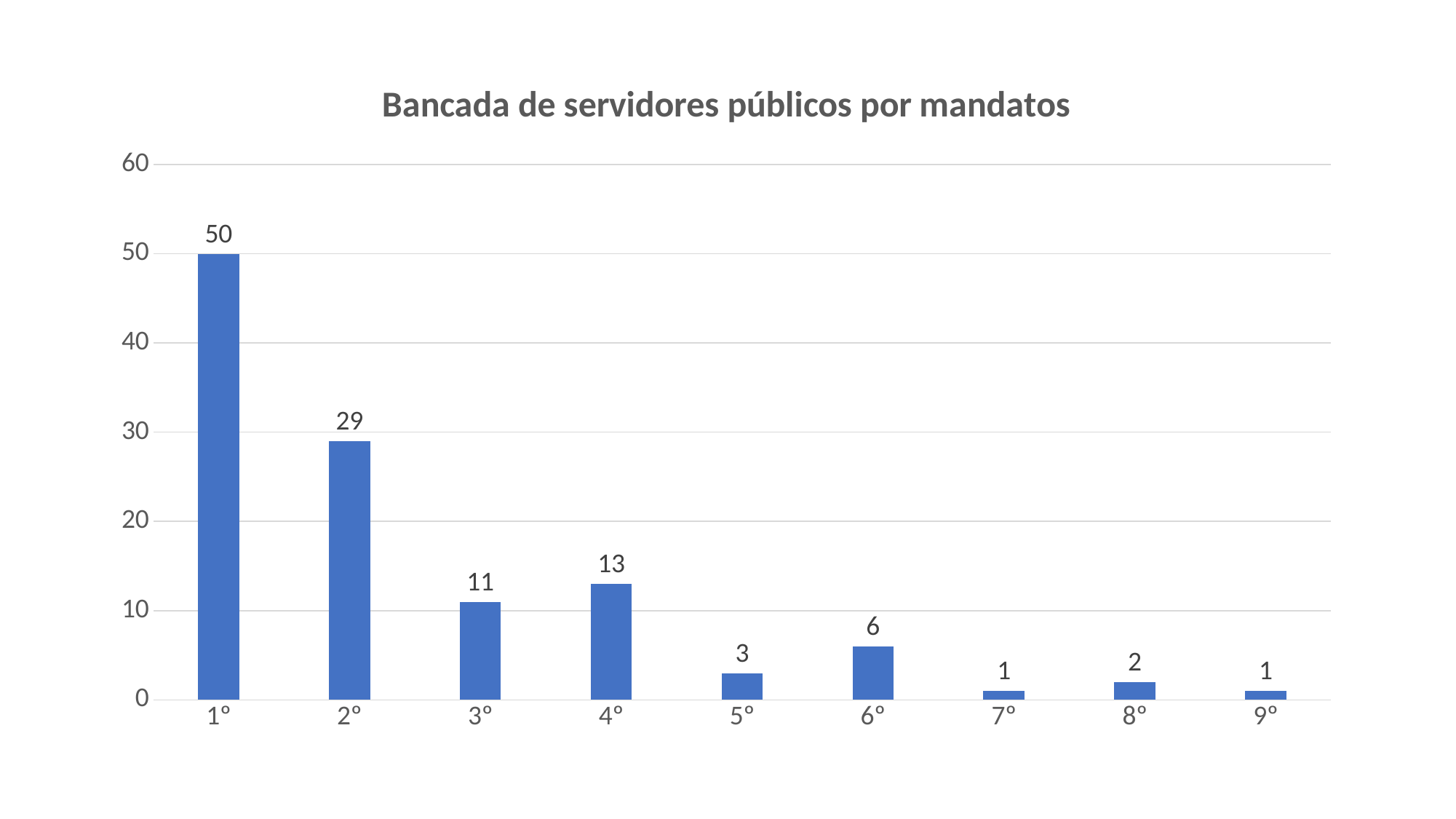
What kind of chart is shown on the slide? bar chart Which is larger, the value for 5° or the value for 6°? 6° What is the difference between the values for 1° and 2°? 21 What is the value for 6° in the chart? 6 What is the value for 1° in the chart? 50 Is the value for 2° greater or less than 20? greater What is the difference between the values for 4° and 3°? 2 What is the title of the chart? Bancada de servidores públicos por mandatos How many categories are shown on the x axis? 9 Which is larger, the value for 3° or the value for 4°? 4° Which category has the highest value? 1° What is the value for 4° in the chart? 13